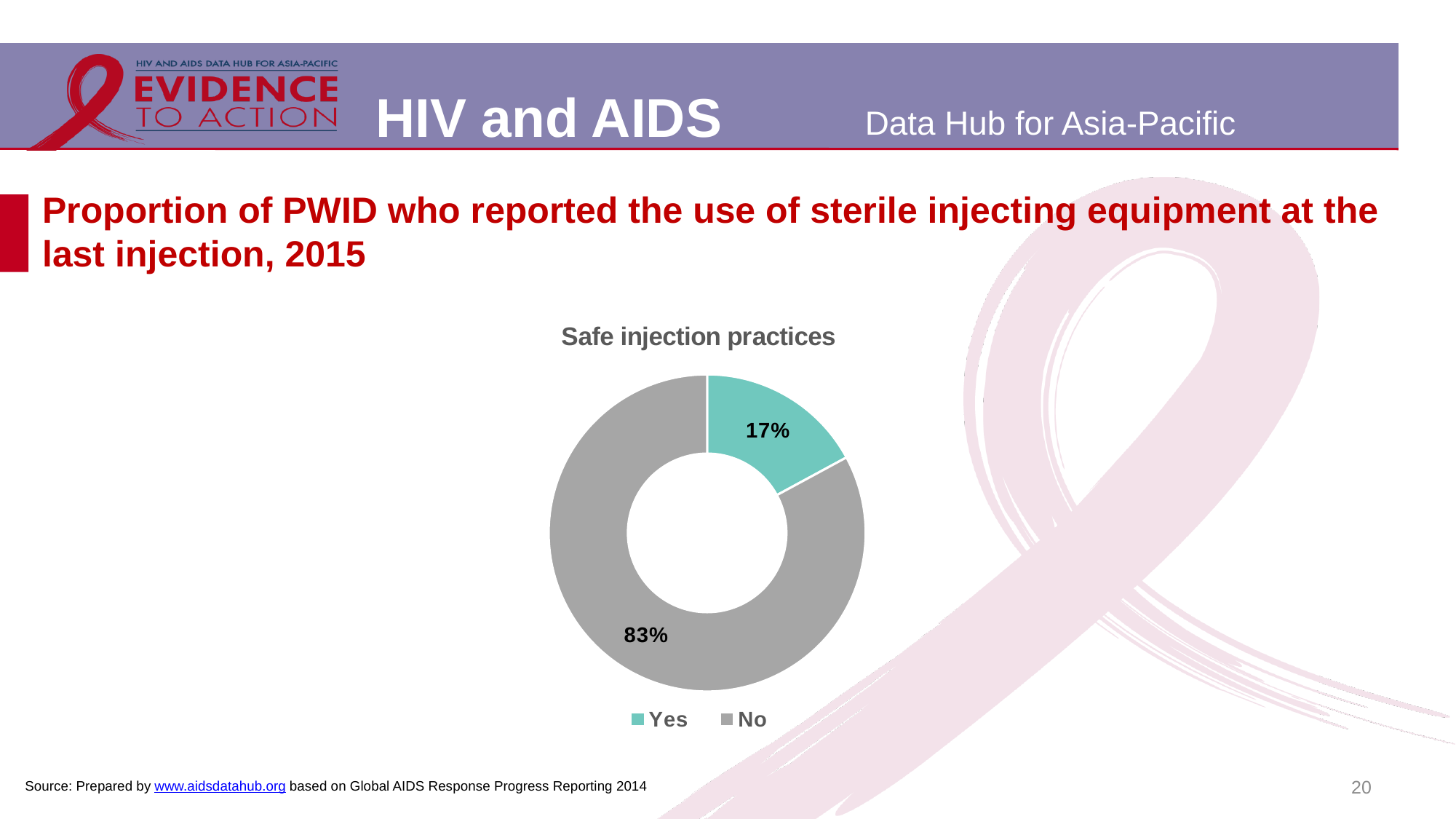
What colour is the "Yes" slice in the chart? Teal Which is larger, the "Yes" slice or the "No" slice? No Which category has the smallest slice of the pie? Yes Which category has the largest slice of the pie? No What share of the pie is labelled "No"? 83% What is the total of the two slices shown in the chart? 100% What is the difference in percentage points between the "No" and "Yes" slices? 66 What kind of chart is shown on the slide? Pie chart (doughnut) How many categories does the pie chart show? 2 What share of the pie is labelled "Yes"? 17% What is the title of the chart? Safe injection practices